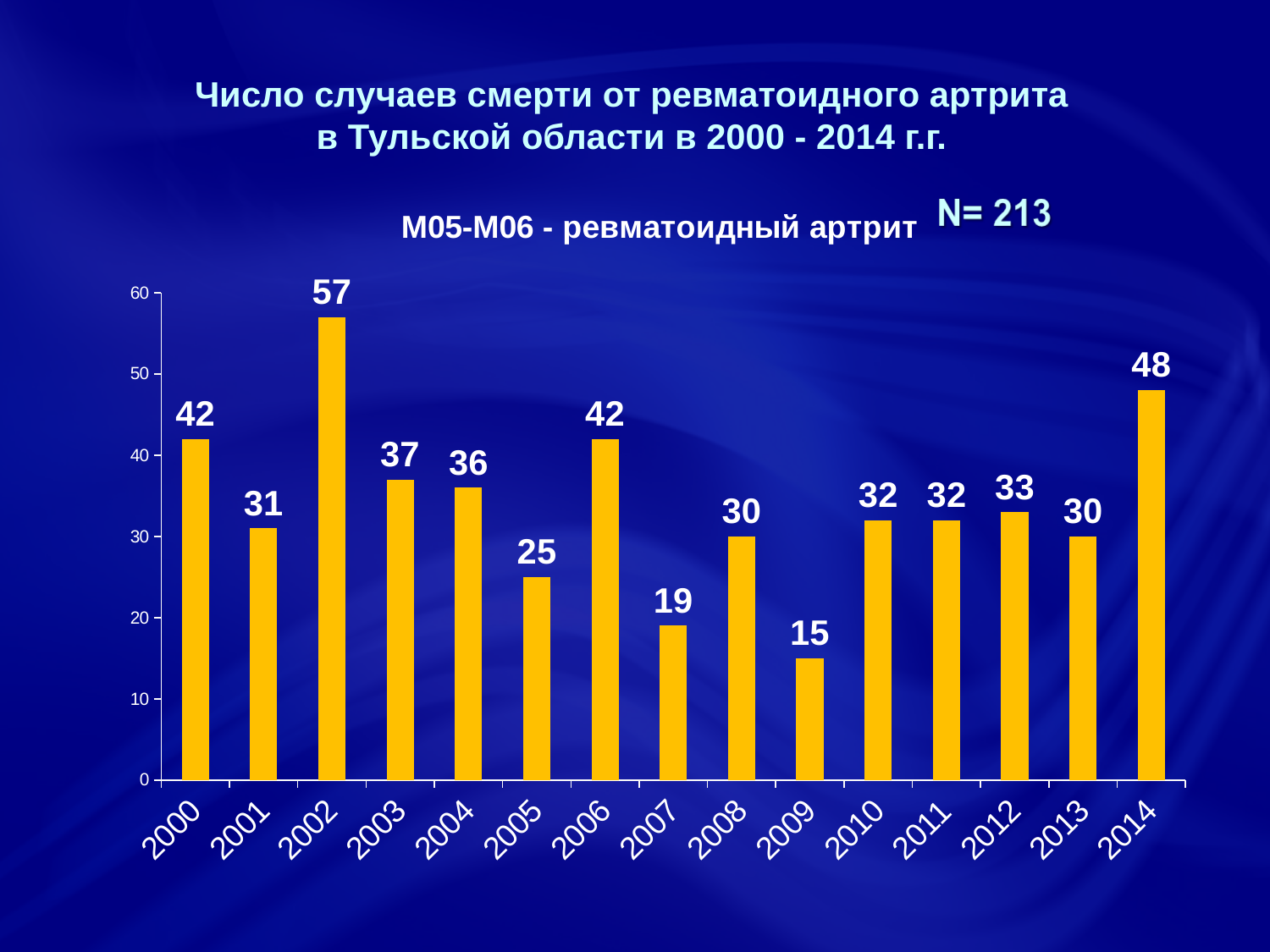
What is the value for 2009? 15 Which year has the lowest value? 2009 What is the N value shown on the slide? N= 213 What is the difference between the values for 2002 and 2009? 42 Which is larger, the value for 2003 or the value for 2004? 2003 Which year has the highest value? 2002 Is the value for 2007 greater or less than 20? less What kind of chart is this? bar chart What is the value for 2002? 57 How many years are shown on the x axis? 15 What is the value for 2014? 48 Do the values rise or fall from 2006 to 2007? fall